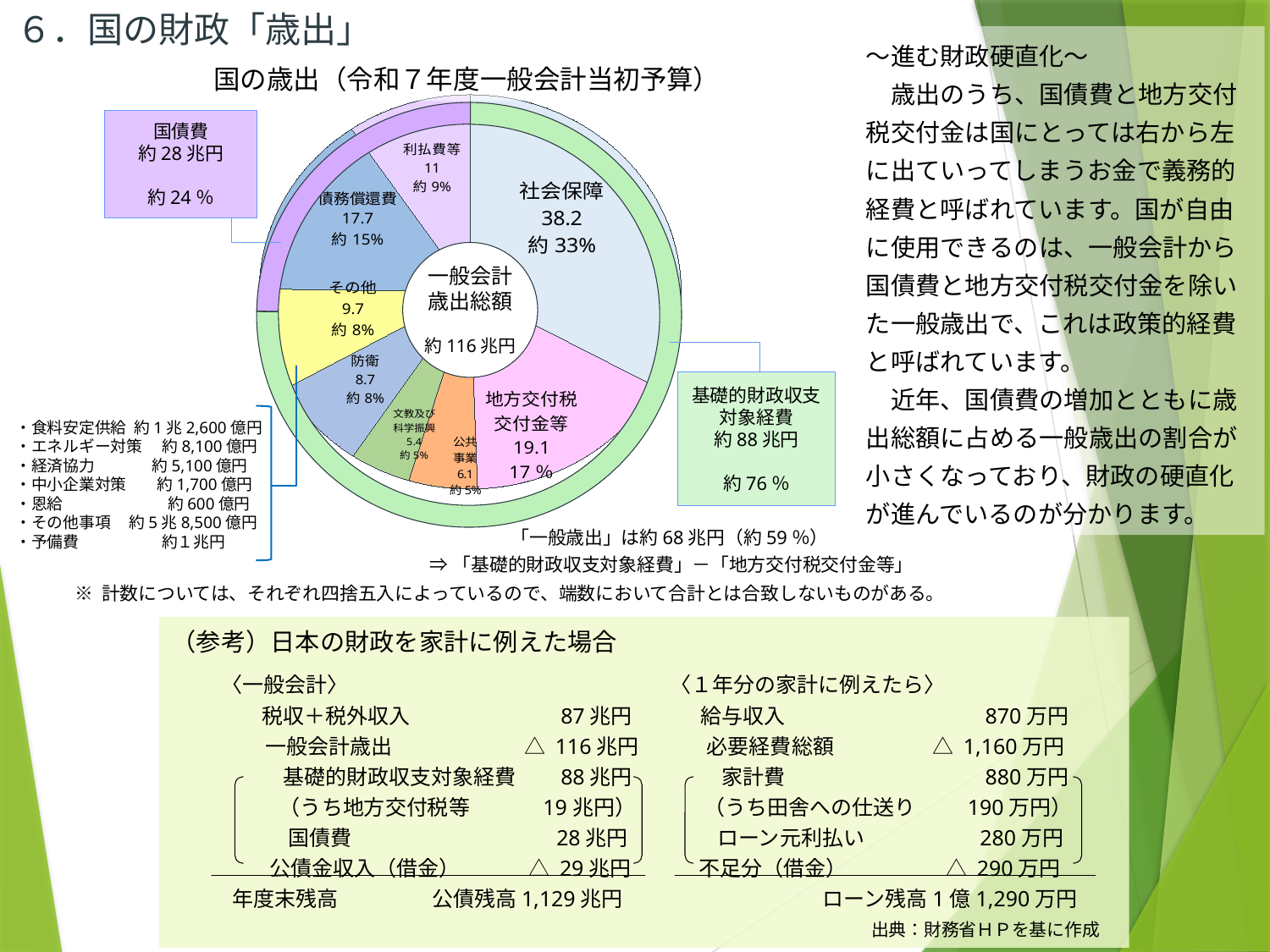
国の歳出のグラフの中心に示されている一般会計歳出総額はいくらですか？ 約 116 兆円 国の歳出のグラフで、基礎的財政収支対象経費の金額はいくらですか？ 約 88 兆円 国の歳出のグラフで、社会保障と地方交付税交付金等の差はいくらですか？ 19.1 国の歳出のグラフで、最も小さい項目はどれですか？ 文教及び科学振興 国の歳出のグラフで、国債費の割合は何％ですか？ 約 24 % 国の歳出のグラフで、防衛の金額はいくらですか？ 8.7 国の歳出のグラフで、地方交付税交付金等の割合は何％ですか？ 約 17 % 国の歳出のグラフで、最も大きい項目はどれですか？ 社会保障 国の歳出のグラフで、債務償還費と利払費等ではどちらが大きいですか？ 債務償還費 国の歳出（令和７年度一般会計当初予算）のグラフで、社会保障の金額はいくらですか？ 38.2 国の歳出のグラフはどの種類のグラフですか？ 円グラフ 国の歳出のグラフの内側の円には、いくつの項目がありますか？ 8